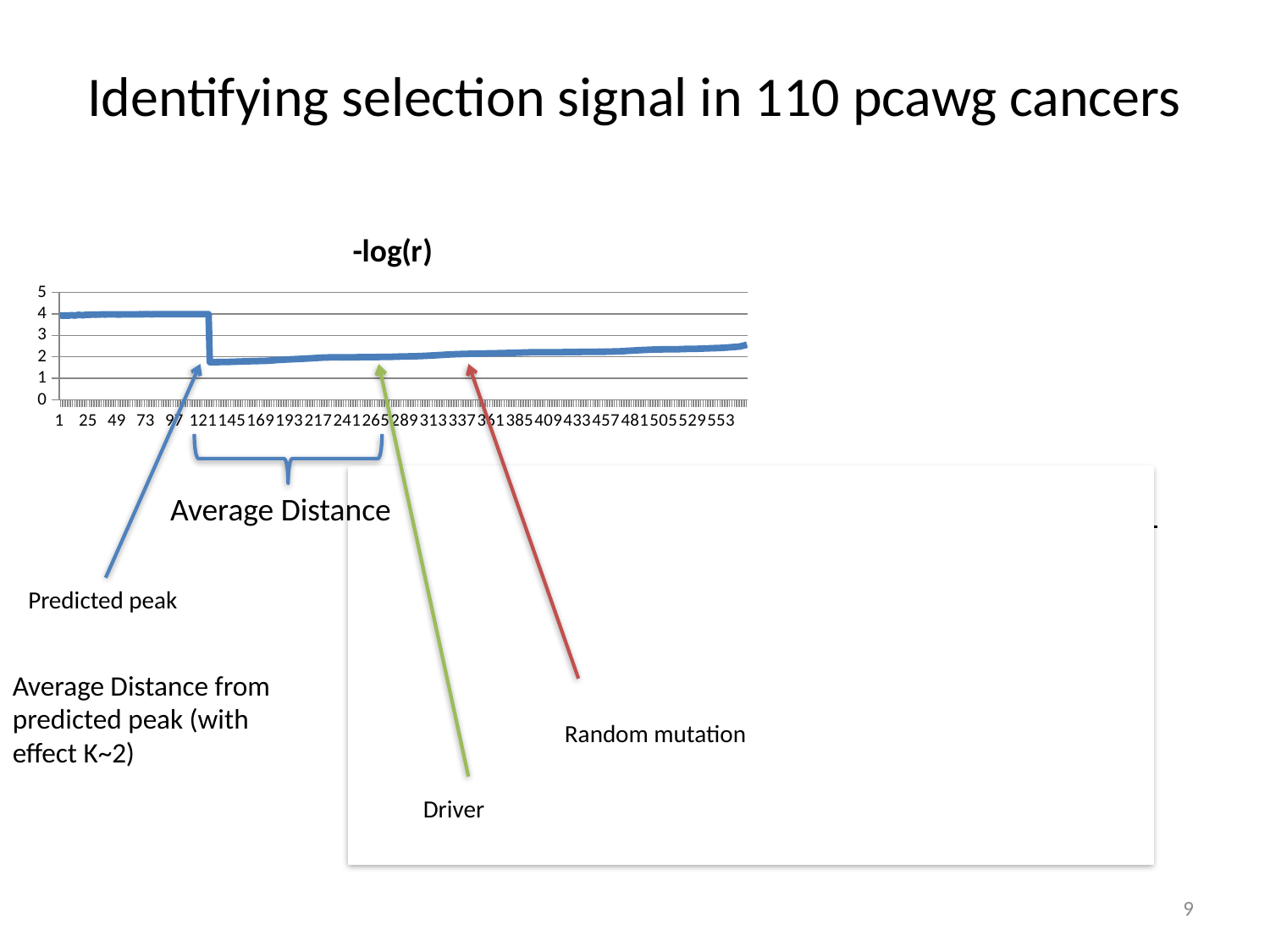
Is the value of the line at x = 1 greater or less than 3? greater Is the value of the line at x = 145 greater or less than 3? less Which is larger, the value of the line at x = 145 or at x = 553? x = 553 What kind of chart is shown on the slide? line chart Is the value of the line at x = 553 greater or less than 3? less What is the highest value shown on the chart's vertical axis? 5 Does the line rise or fall between x = 1 and x = 145? fall What is the title of the chart? -log(r) Which is larger, the value of the line at x = 97 or at x = 193? x = 97 After the sharp drop near x = 121, does the line rise or fall as x increases toward 553? rise